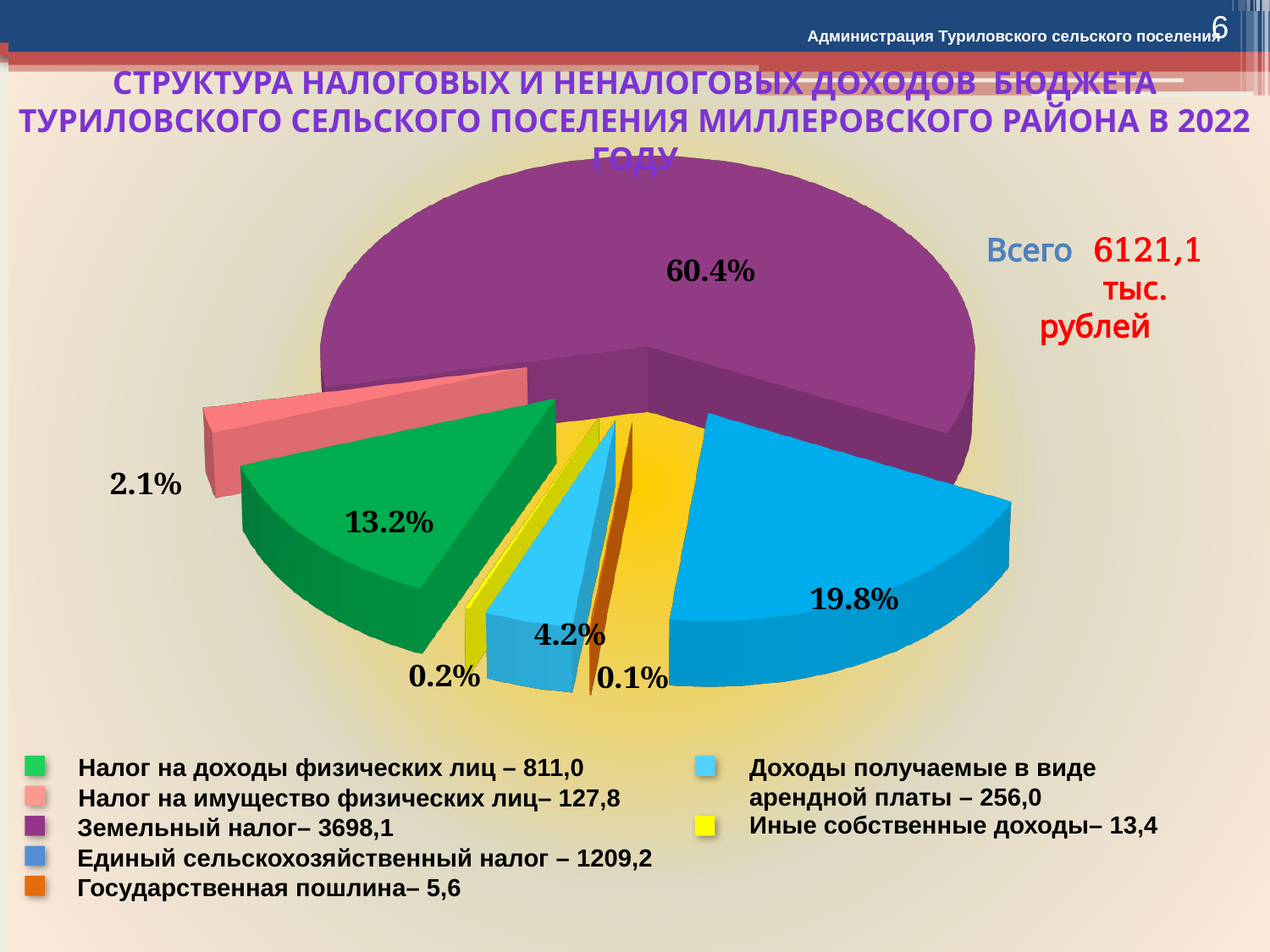
Which category has the smallest share of the pie? Государственная пошлина What percentage share is shown for Единый сельскохозяйственный налог? 19.8% What kind of chart is shown on the slide? Pie chart What percentage share is shown for Земельный налог? 60.4% What total amount (Всего) is shown next to the pie chart? 6121,1 тыс. рублей What is the difference in percentage points between the share for Земельный налог and the share for Единый сельскохозяйственный налог? 40.6 What value (in thousand rubles) is listed in the legend for Налог на имущество физических лиц? 127,8 What percentage share is shown for Доходы получаемые в виде арендной платы? 4.2% Which category has the largest share of the pie? Земельный налог How many slices does the pie chart have? 7 Which is larger: the share for Налог на доходы физических лиц or the share for Налог на имущество физических лиц? Налог на доходы физических лиц